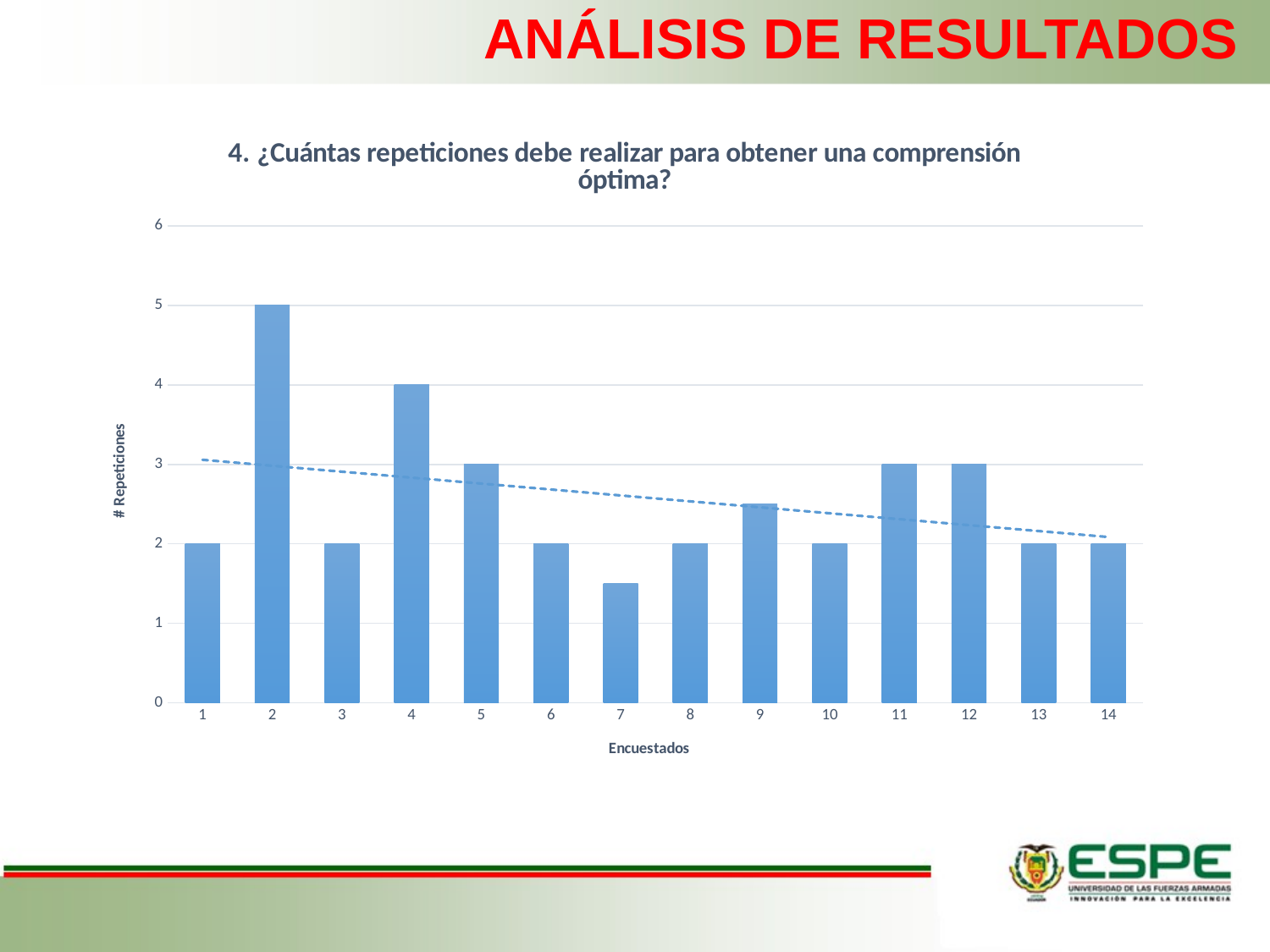
Is the value for encuestado 7 greater or less than 2? less Which encuestado has the highest number of repeticiones? 2 Does the dashed trend line rise or fall from left to right across the chart? falls Which encuestado has the lowest number of repeticiones? 7 Which has more repeticiones, encuestado 4 or encuestado 11? encuestado 4 How many encuestados (respondents) are shown on the x axis? 14 How many repeticiones did encuestado 11 indicate? 3 Is the value for encuestado 9 greater or less than 2? greater What is the difference in repeticiones between encuestado 2 and encuestado 4? 1 How many repeticiones did encuestado 4 indicate? 4 How many repeticiones did encuestado 2 indicate? 5 What kind of chart is shown on the slide? bar chart